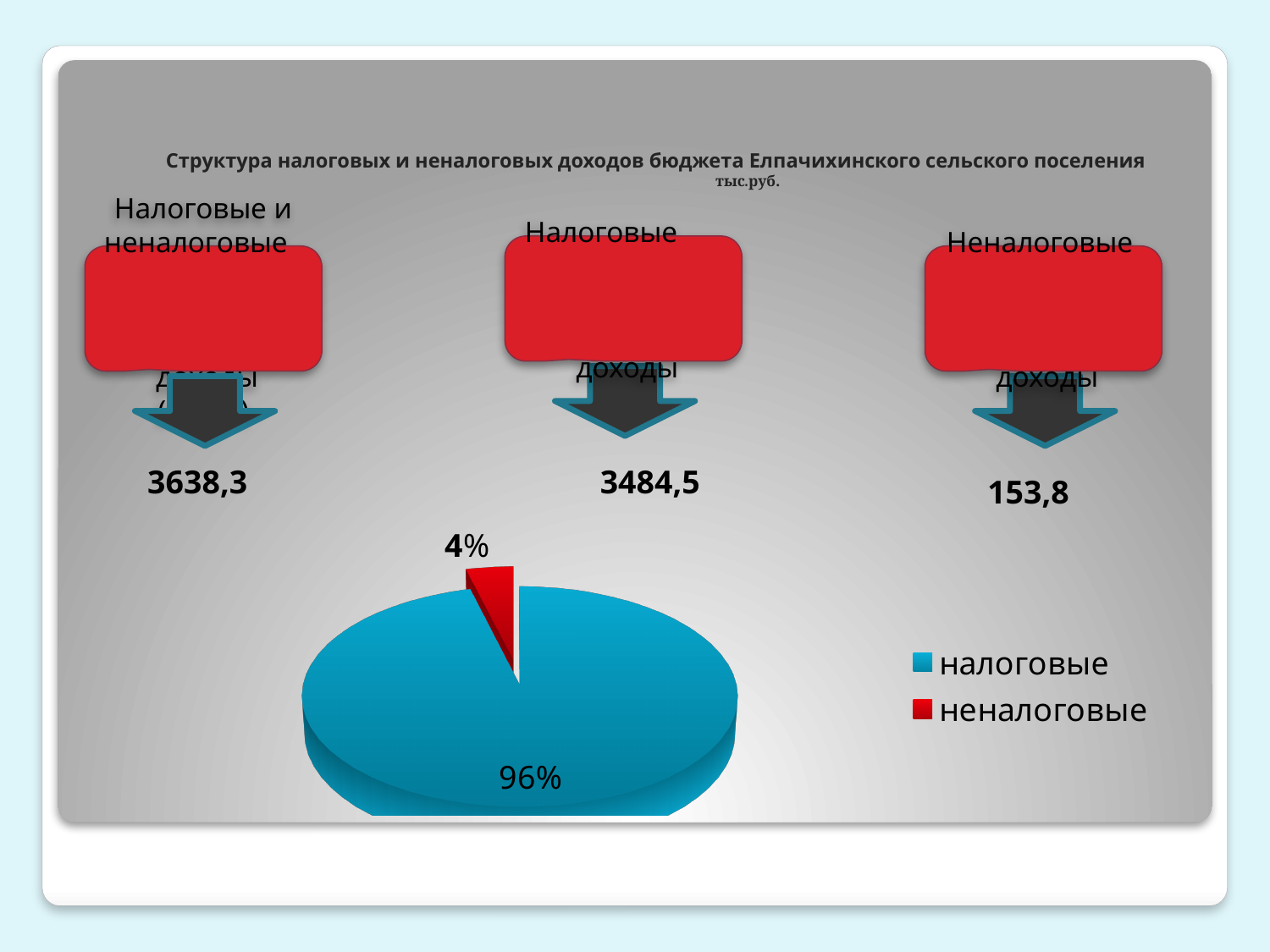
Which slice of the pie chart is the smallest? неналоговые What share of the pie does the налоговые slice represent? 96% Which slice of the pie chart is the largest? налоговые What is the difference in percentage points between the налоговые and неналоговые slices? 92 percentage points What colour is the неналоговые slice in the pie chart? red What kind of chart is shown on the slide? pie chart Which is larger in the pie chart, налоговые or неналоговые? налоговые What share of the pie does the неналоговые slice represent? 4% How many entries does the legend of the pie chart list? 2 How many slices does the pie chart have? 2 What colour is the налоговые slice in the pie chart? blue